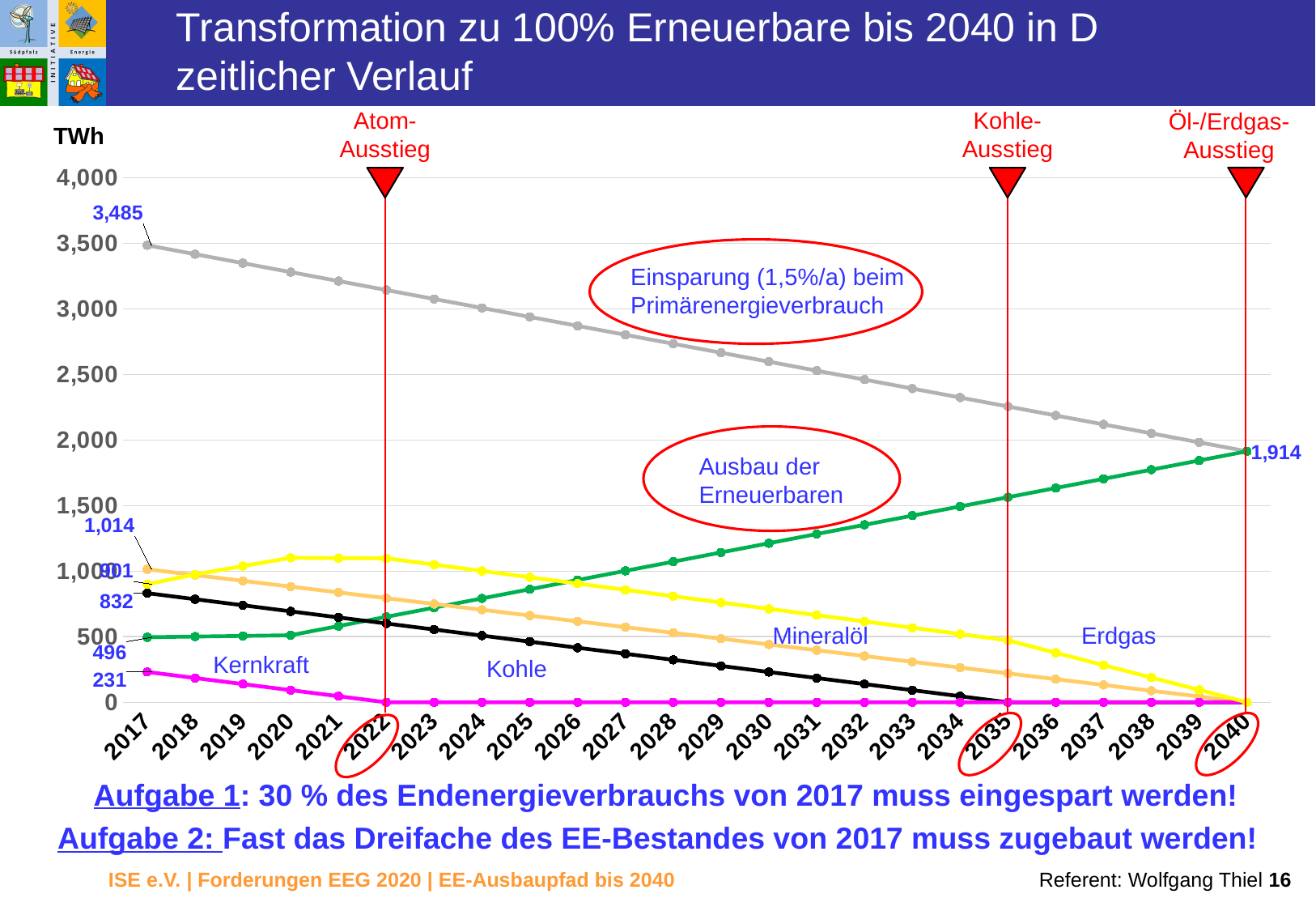
What kind of chart is shown on the slide? line chart In which year is the Kohle-Ausstieg marked on the chart? 2035 What is the value of the topmost (gray) line in 2017? 3,485 What value is labelled at the right end of the chart in 2040, where the gray and green lines meet? 1,914 What is the value of the green (Erneuerbare) line in 2017? 496 What is the value of the Kernkraft (magenta) line in 2017? 231 Does the green (Erneuerbare) line rise or fall from 2017 to 2040? rise What is the value of the Kohle (black) line in 2017? 832 How many years are shown on the x axis? 24 Is the value of the Kohle (black) line in 2030 greater or less than 500? less Does the gray (Primärenergieverbrauch) line rise or fall from 2017 to 2040? fall By how much does the gray line fall from 2017 (3,485) to 2040 (1,914)? 1,571